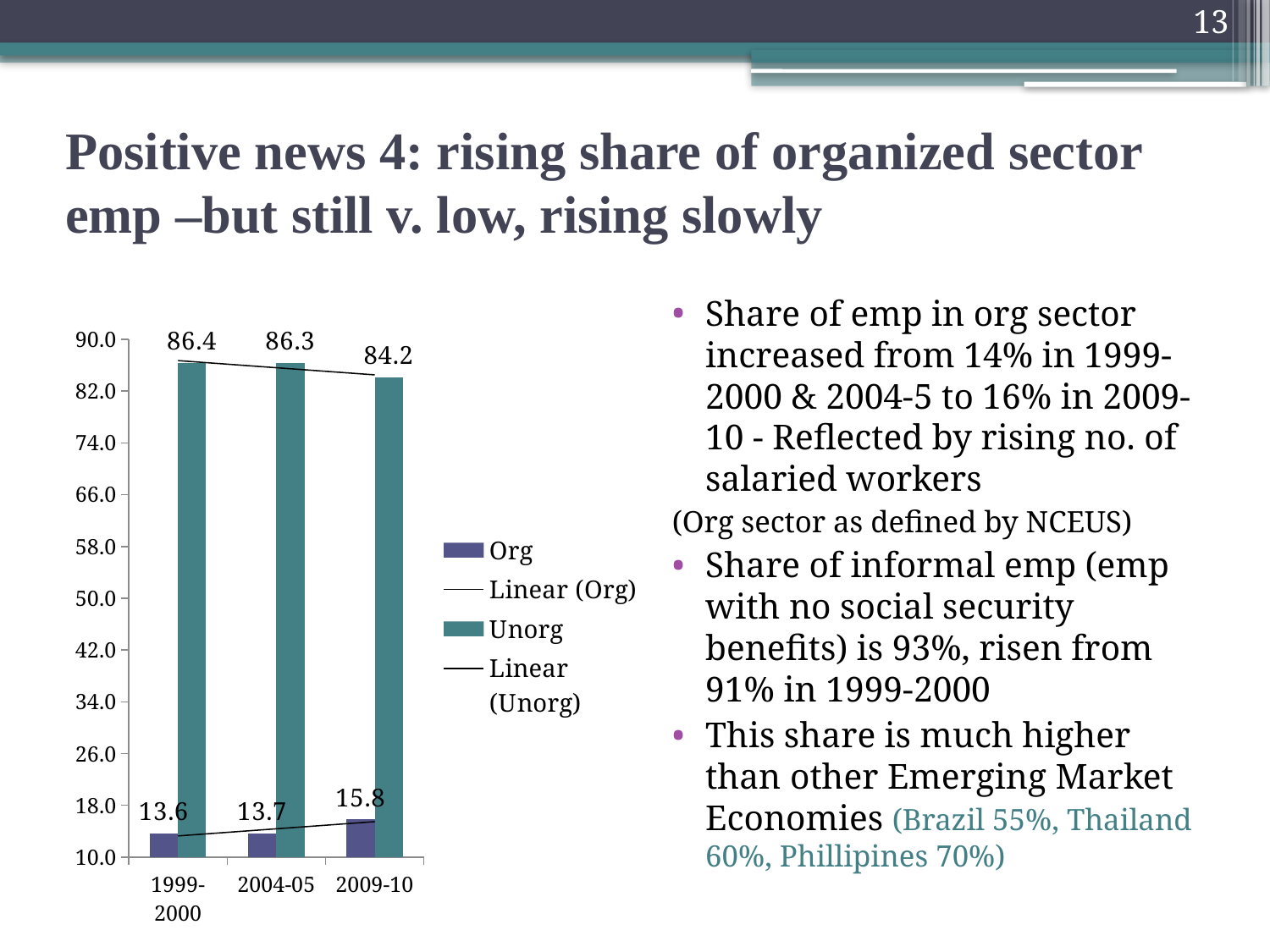
In which period is the Org series highest? 2009-10 In which period is the Unorg series lowest? 2009-10 What is the value of the Org series for 2004-05? 13.7 What is the value of the Org series for 2009-10? 15.8 How many time periods are shown on the x axis? 3 What is the difference between the Unorg values for 1999-2000 and 2009-10? 2.2 Is the Org value for 1999-2000 greater or less than 18.0? less By how much did the Org value increase from 1999-2000 to 2009-10? 2.2 Which is larger, the Org value for 2004-05 or for 2009-10? 2009-10 How many entries does the legend list? 4 What kind of chart is shown on the slide? bar chart What is the value of the Unorg series for 1999-2000? 86.4